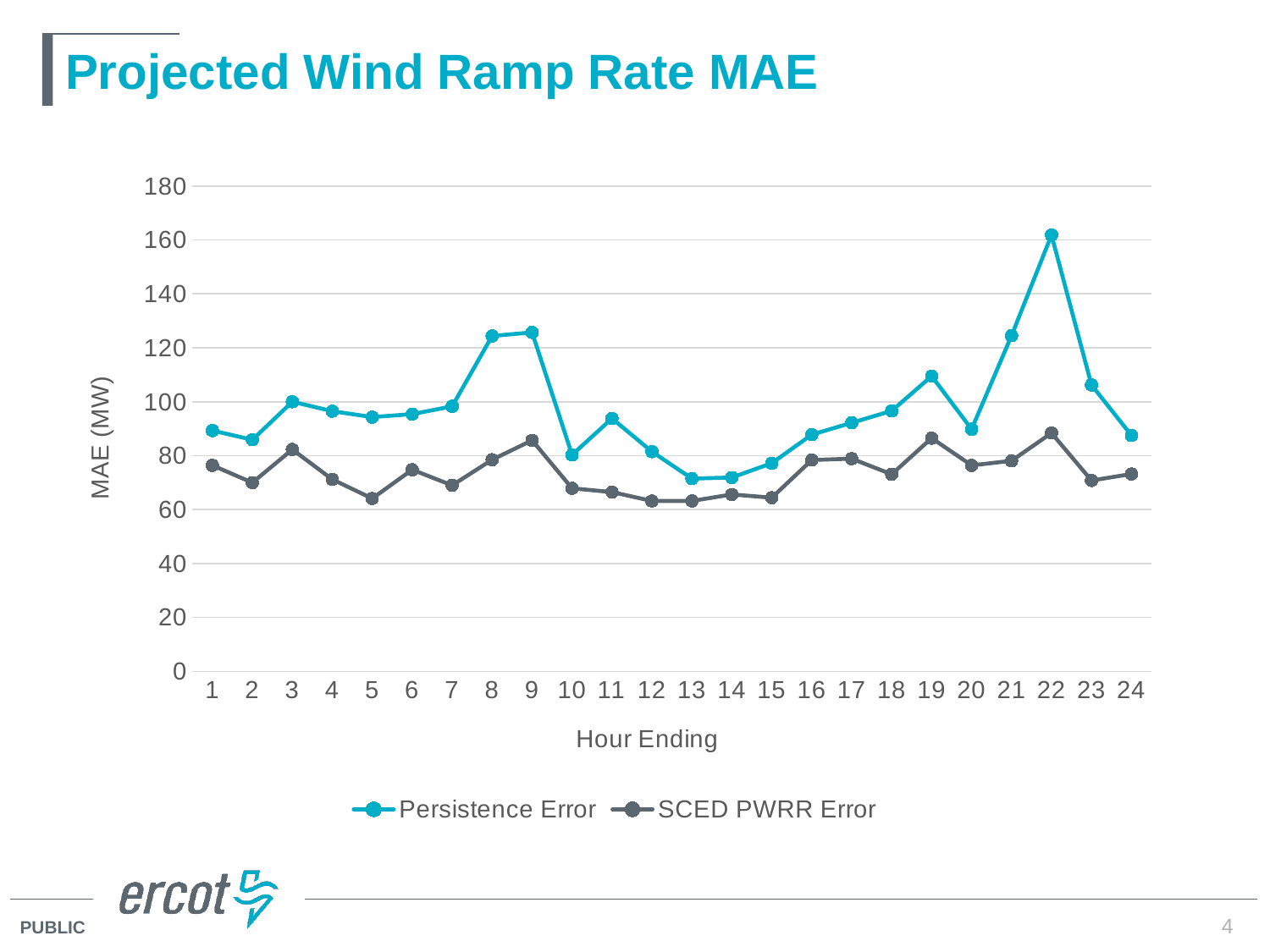
What kind of chart is shown on the slide? Line chart What is the label on the y axis? MAE (MW) At which hour ending does the Persistence Error reach its highest value? 22 Is the Persistence Error at hour ending 10 greater or less than 100? less At hour ending 22, which series has the larger value, Persistence Error or SCED PWRR Error? Persistence Error How many series does the legend list? 2 Does the Persistence Error rise or fall from hour ending 22 to hour ending 24? Fall Is the Persistence Error at hour ending 8 greater or less than 120? greater How many hours are plotted along the x axis? 24 Is the Persistence Error at hour ending 22 greater or less than 140? greater Which series is higher across all hours, Persistence Error or SCED PWRR Error? Persistence Error